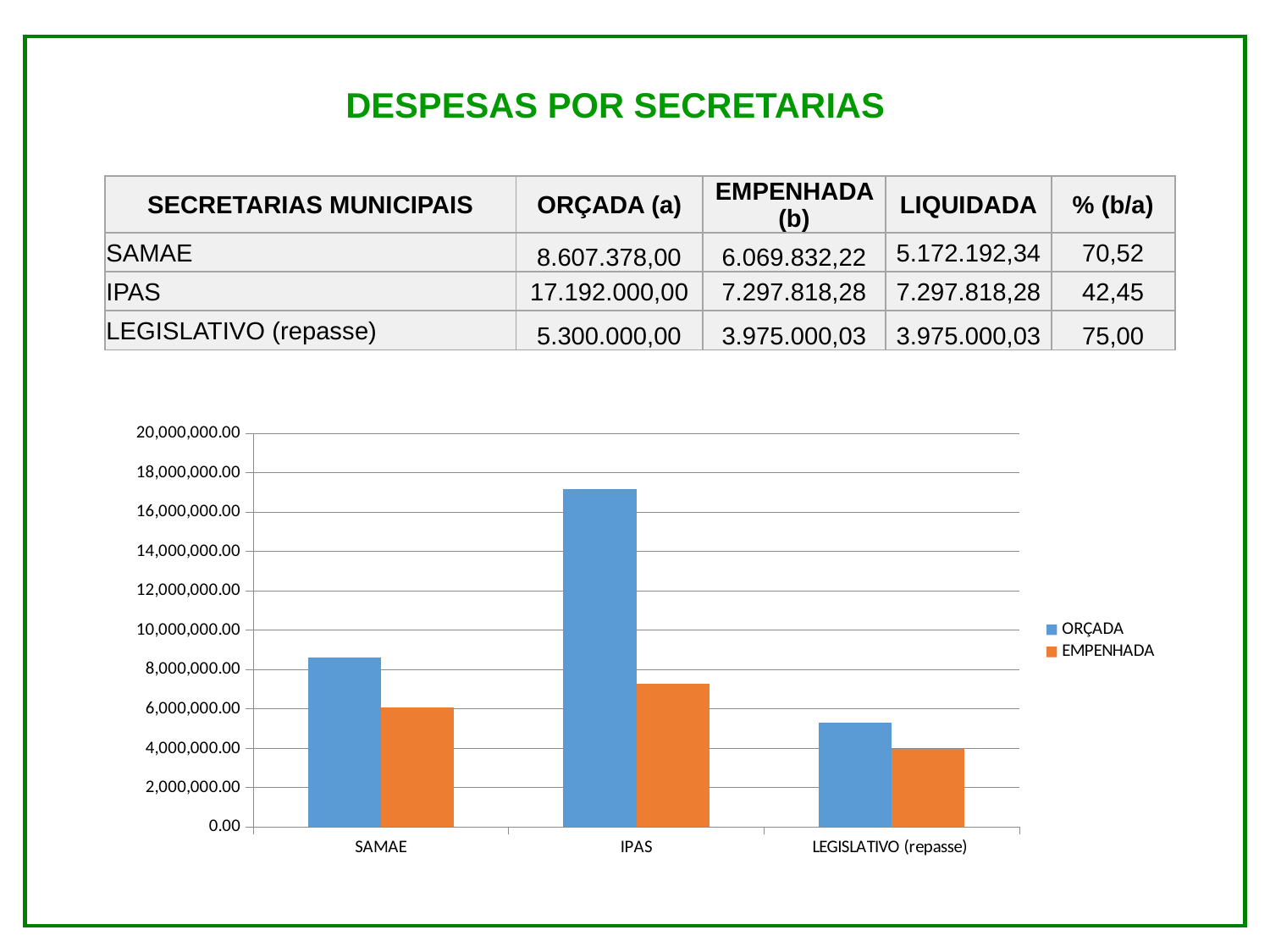
Which category has the highest EMPENHADA value in the chart? IPAS What is the ORÇADA value for IPAS? 17.192.000,00 How many categories are shown on the x axis of the chart? 3 Is the EMPENHADA value for IPAS greater or less than 8,000,000.00? less Is the ORÇADA value for IPAS greater or less than 16,000,000.00? greater What kind of chart is shown on the slide? bar chart What is the EMPENHADA value for SAMAE? 6.069.832,22 What colour are the ORÇADA bars in the chart? blue Which category has the highest ORÇADA value in the chart? IPAS How many series does the chart legend list? 2 For SAMAE, which is larger: ORÇADA or EMPENHADA? ORÇADA Which category has the lowest ORÇADA value in the chart? LEGISLATIVO (repasse)